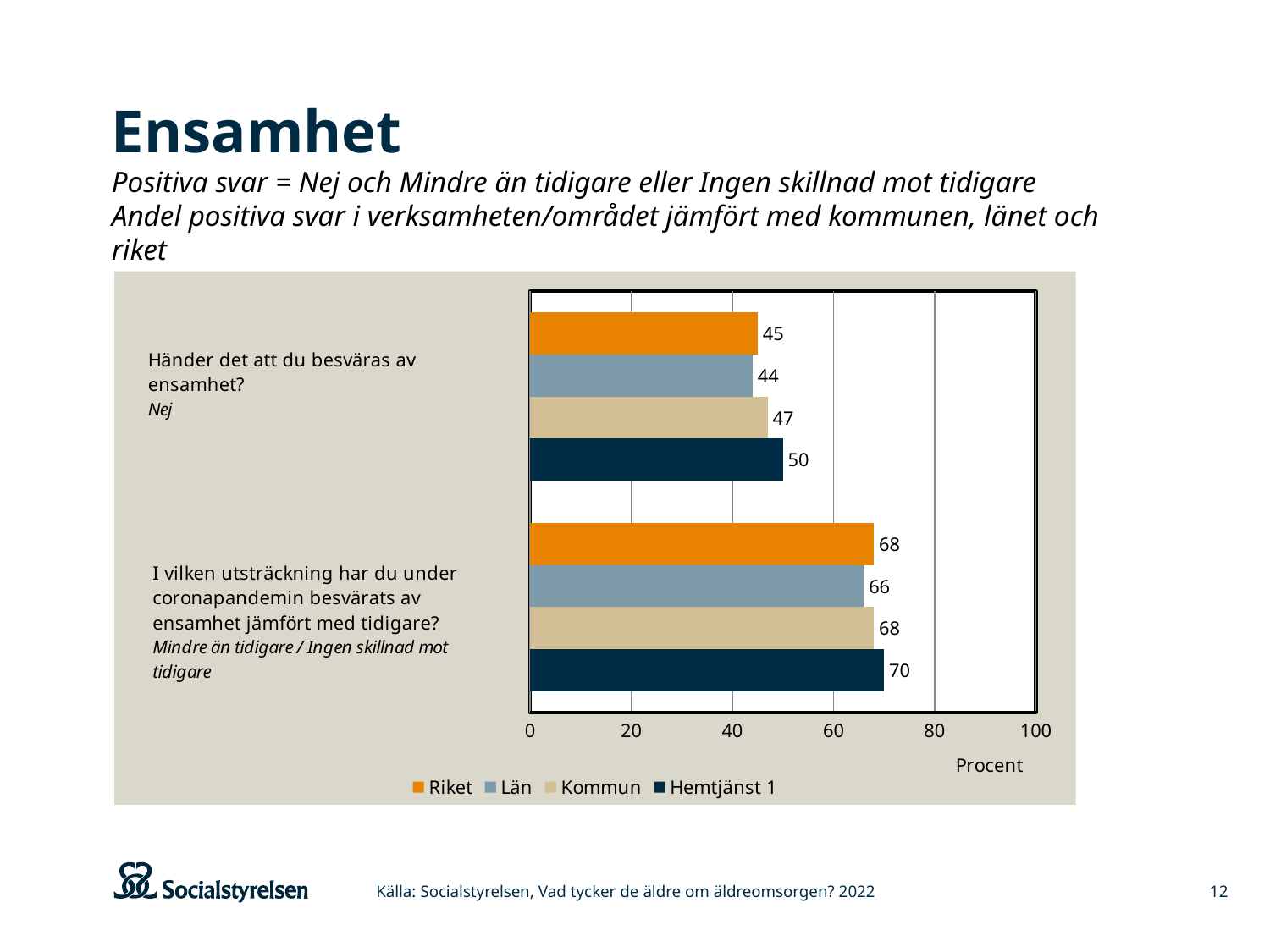
Which series has the highest value for the question "I vilken utsträckning har du under coronapandemin besvärats av ensamhet jämfört med tidigare?"? Hemtjänst 1 What is the value for Hemtjänst 1 for the question "Händer det att du besväras av ensamhet?"? 50 What is the value for Län for the question "Händer det att du besväras av ensamhet?"? 44 How many series does the legend list? 4 Is the value for Hemtjänst 1 for the question "I vilken utsträckning har du under coronapandemin besvärats av ensamhet jämfört med tidigare?" greater or less than 60? greater What is the difference between Hemtjänst 1 and Län for the question "Händer det att du besväras av ensamhet?"? 6 What is the label on the horizontal axis of the chart? Procent For the question "Händer det att du besväras av ensamhet?", which is larger: Kommun or Riket? Kommun What is the difference between Hemtjänst 1 and Riket for the question "I vilken utsträckning har du under coronapandemin besvärats av ensamhet jämfört med tidigare?"? 2 What kind of chart is shown on the slide? Bar chart Which series has the lowest value for the question "Händer det att du besväras av ensamhet?"? Län What is the value for Riket for the question "I vilken utsträckning har du under coronapandemin besvärats av ensamhet jämfört med tidigare?"? 68